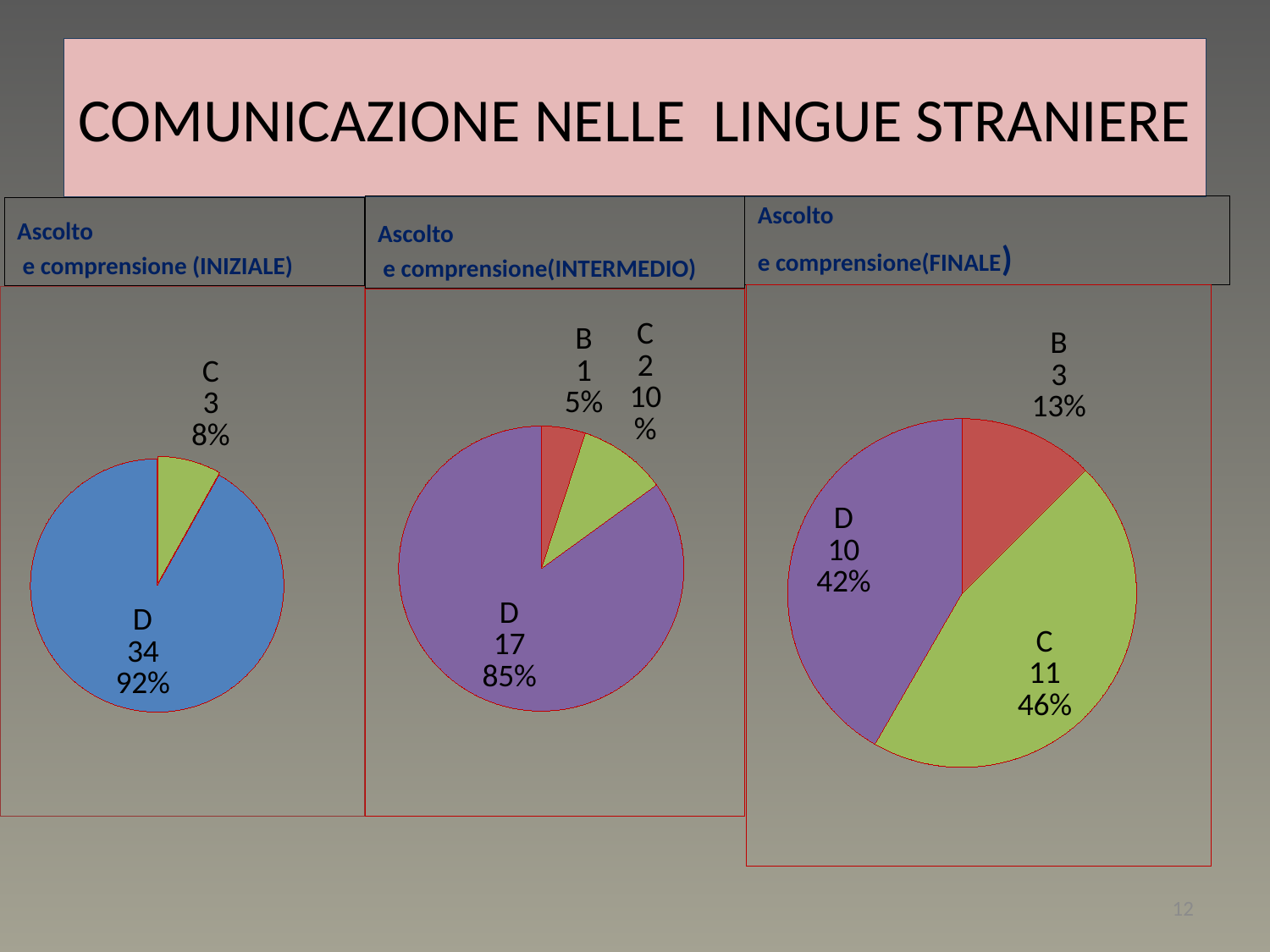
In the 'Ascolto e comprensione (INIZIALE)' chart, how many categories are shown? 2 In the 'Ascolto e comprensione (INIZIALE)' chart, what percentage share does category C have? 8% In the 'Ascolto e comprensione (INIZIALE)' chart, what value is shown for category D? 34 In the 'Ascolto e comprensione (INTERMEDIO)' chart, what percentage share does category D have? 85% In the 'Ascolto e comprensione (FINALE)' chart, which category has the smallest slice? B In the 'Ascolto e comprensione (INTERMEDIO)' chart, which is larger, the value for C or the value for B? C In the 'Ascolto e comprensione (FINALE)' chart, what is the difference between the values for C and D? 1 What type of chart is used in the 'Ascolto e comprensione (FINALE)' panel? Pie chart In the 'Ascolto e comprensione (INTERMEDIO)' chart, what value is shown for category B? 1 In the 'Ascolto e comprensione (FINALE)' chart, which category has the largest slice? C In the 'Ascolto e comprensione (INTERMEDIO)' chart, how many categories are shown? 3 In the 'Ascolto e comprensione (FINALE)' chart, what value is shown for category C? 11